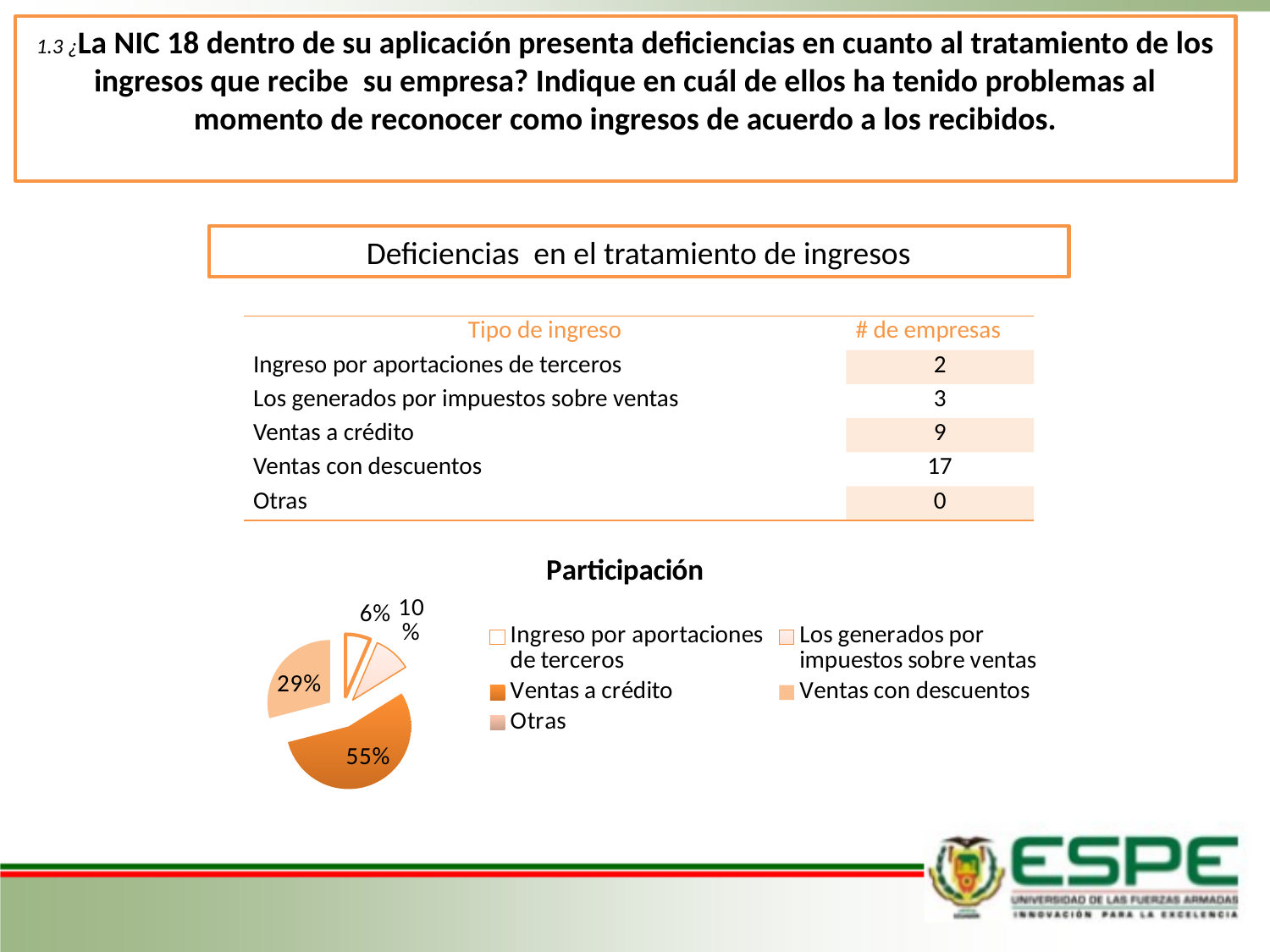
In the "Participación" pie chart, what is the percentage shown on the largest slice? 55% In the "Participación" pie chart, what do the two largest slices (55% and 29%) add up to? 84% In the "Participación" pie chart, what is the difference between the largest slice (55%) and the smallest labelled slice (6%)? 49% What is the title of the pie chart on the slide? Participación What kind of chart is shown under the heading "Participación"? pie chart Which entry is listed last in the legend of the "Participación" pie chart? Otras How many entries does the legend of the "Participación" pie chart list? 5 In the "Participación" pie chart, what is the percentage shown on the smallest labelled slice? 6% In the "Participación" pie chart, which is larger: the slice labelled 29% or the slice labelled 10%? 29% How many slices carry a percentage label in the "Participación" pie chart? 4